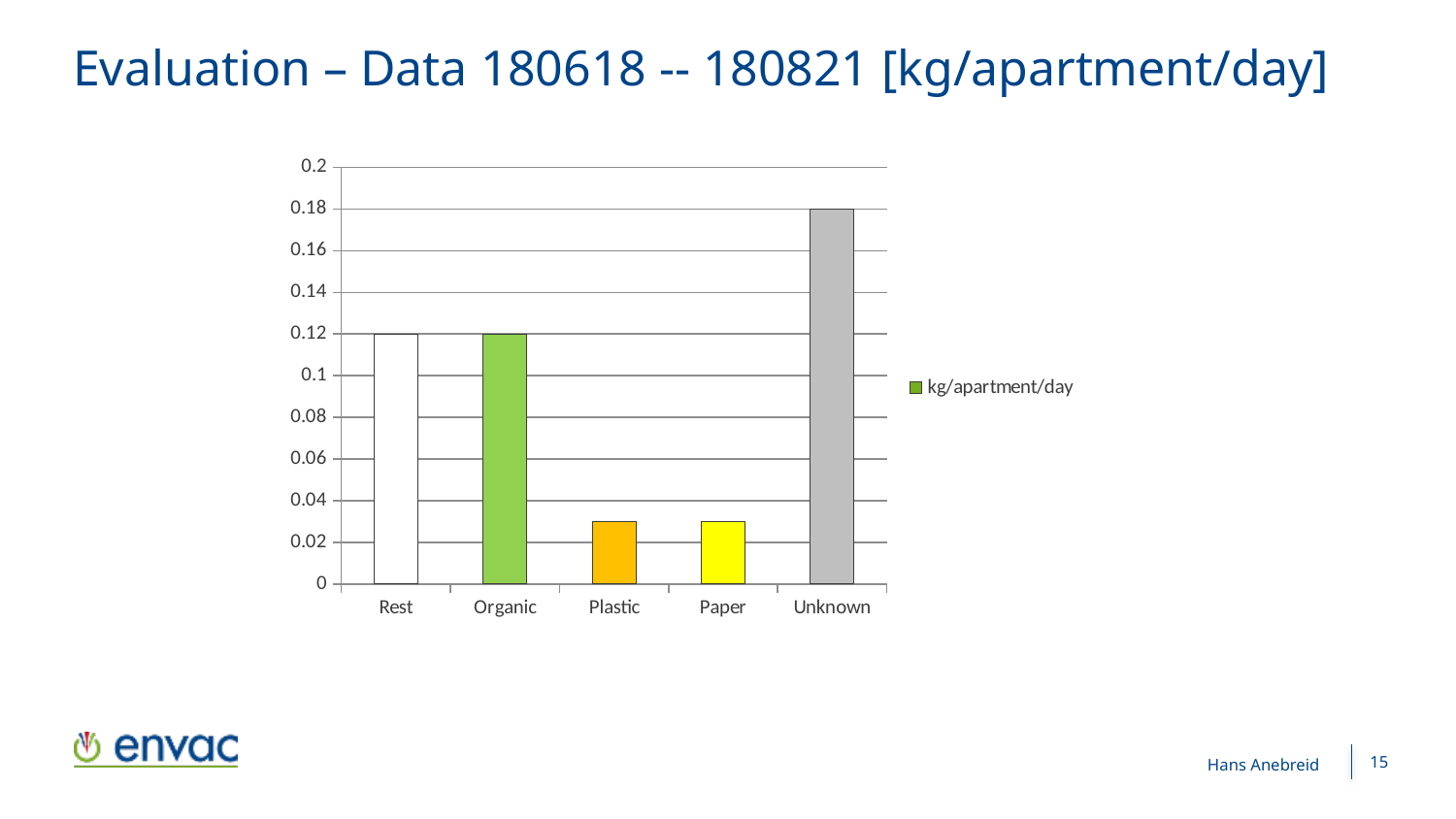
What is the value for Organic? 0.12 Is the value for Paper greater or less than 0.02? greater What kind of chart is shown on the slide? bar chart What is the value for Unknown? 0.18 What is the value for Rest? 0.12 What is the legend entry for the series? kg/apartment/day How many series does the legend list? 1 What is the difference between the values for Unknown and Rest? 0.06 Which is larger, the value for Unknown or the value for Organic? Unknown How many categories are shown on the x axis? 5 Is the value for Plastic greater or less than 0.04? less Which category has the highest value? Unknown